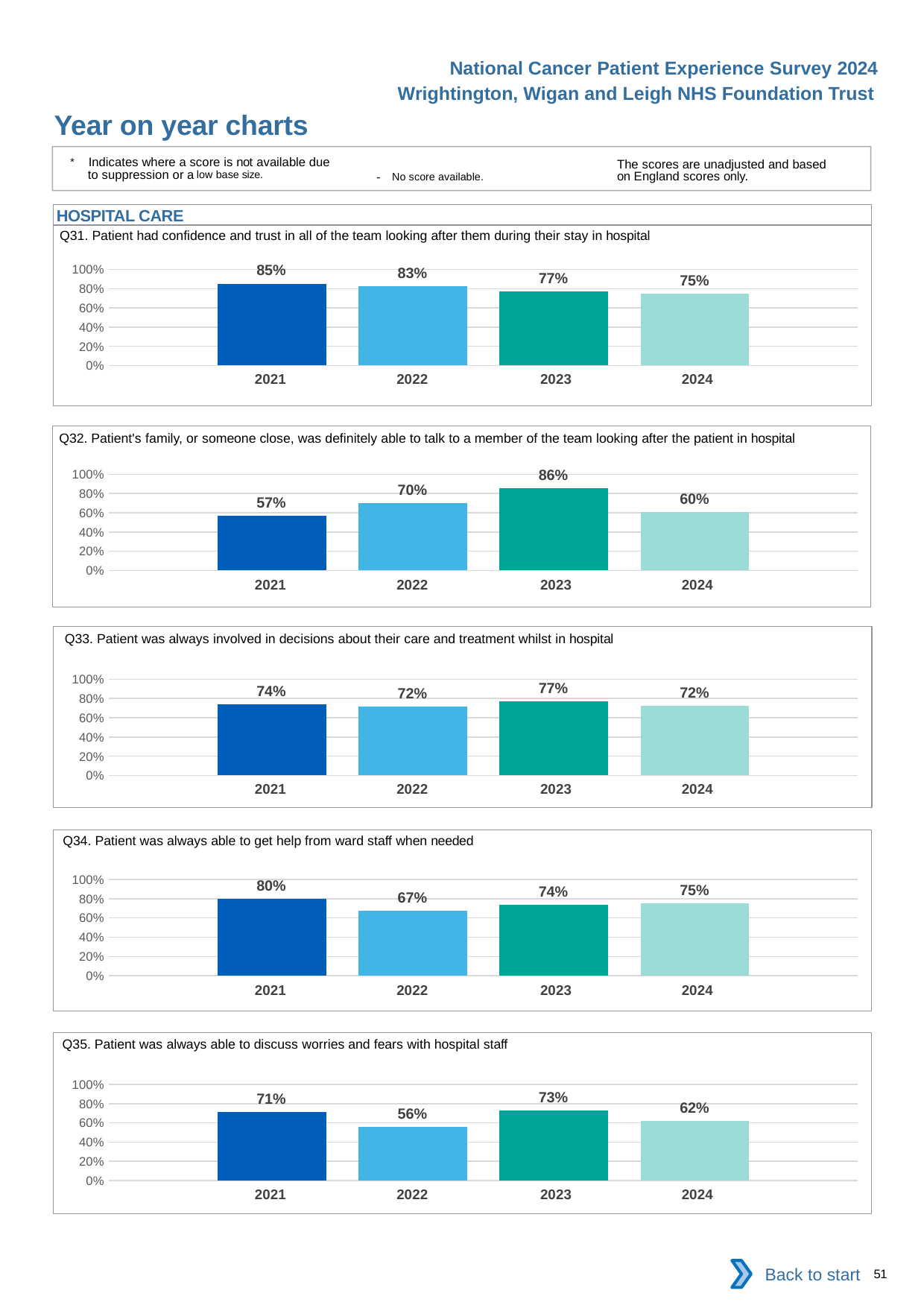
In the Q34 chart (able to get help from ward staff), which is larger, the 2021 value or the 2024 value? 2021 In the Q32 chart (family able to talk to a member of the team), which year has the highest value? 2023 In the Q35 chart (discuss worries and fears with hospital staff), what is the difference between the 2023 and 2024 values? 11% In the Q33 chart (involved in decisions about care), what is the value for 2023? 77% What kind of chart is the Q31 chart? bar chart In the Q35 chart (discuss worries and fears with hospital staff), what is the value for 2022? 56% What is the section heading above the Q31 chart? HOSPITAL CARE In the Q32 chart (family able to talk to a member of the team), what is the difference between the 2023 and 2021 values? 29% In the Q33 chart (involved in decisions about care), how many years are plotted? 4 In the Q31 chart (confidence and trust in the team), what is the value for 2021? 85% In the Q34 chart (able to get help from ward staff), which year has the lowest value? 2022 In the Q31 chart (confidence and trust in the team), do the values rise or fall from 2021 to 2024? fall